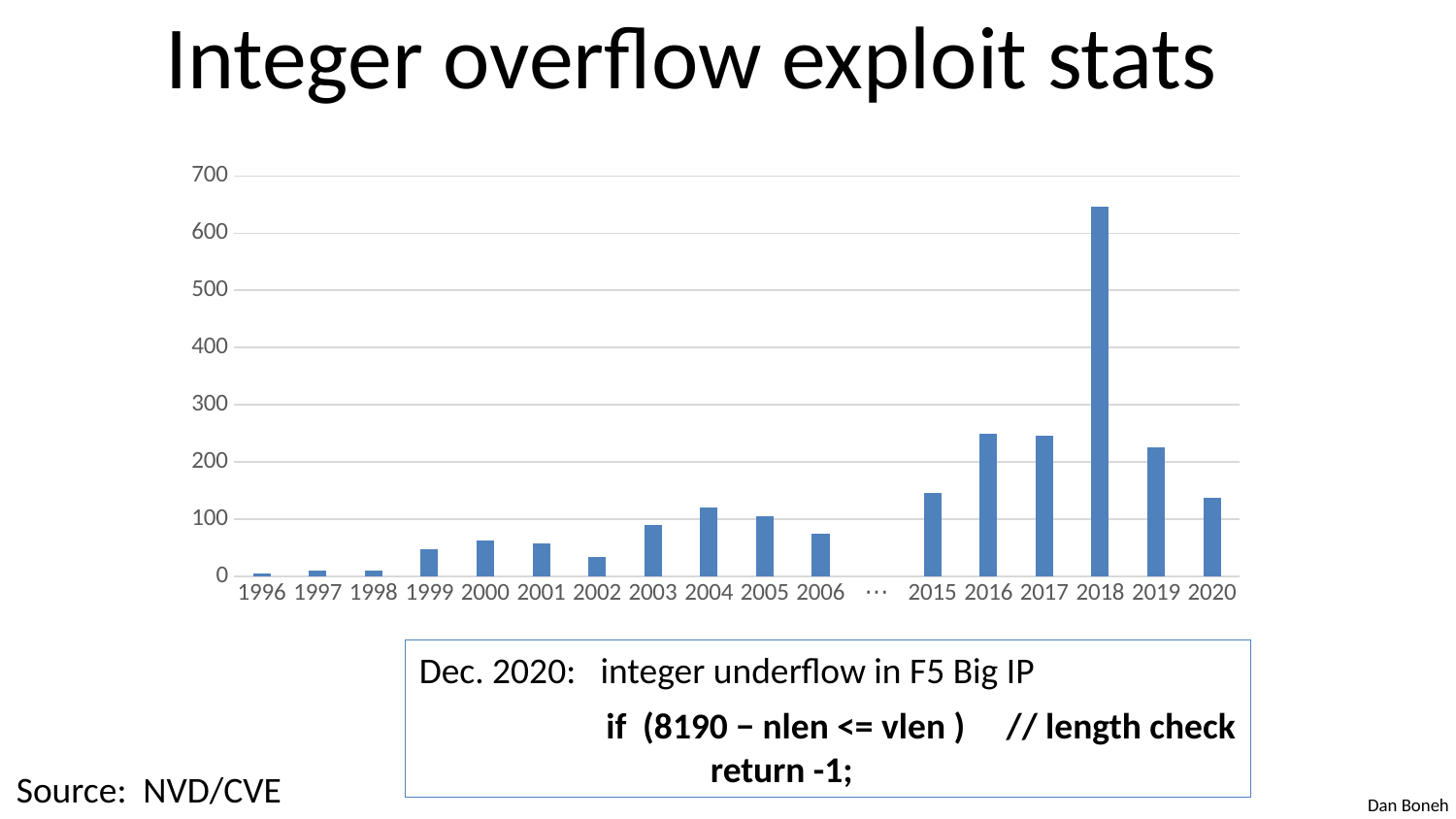
What source is cited for the chart data? NVD/CVE Is the value for 2020 greater or less than 100? greater Is the value for 2018 greater or less than 600? greater Do the values generally rise or fall from 2018 to 2020? fall Is the value for 2017 greater or less than 300? less Which year has the highest number of integer overflow exploits? 2018 Which is larger, the value for 2004 or the value for 2002? 2004 What kind of chart is shown on the slide? bar chart Which is larger, the value for 2019 or the value for 2020? 2019 How many year labels appear on the x axis of the chart? 17